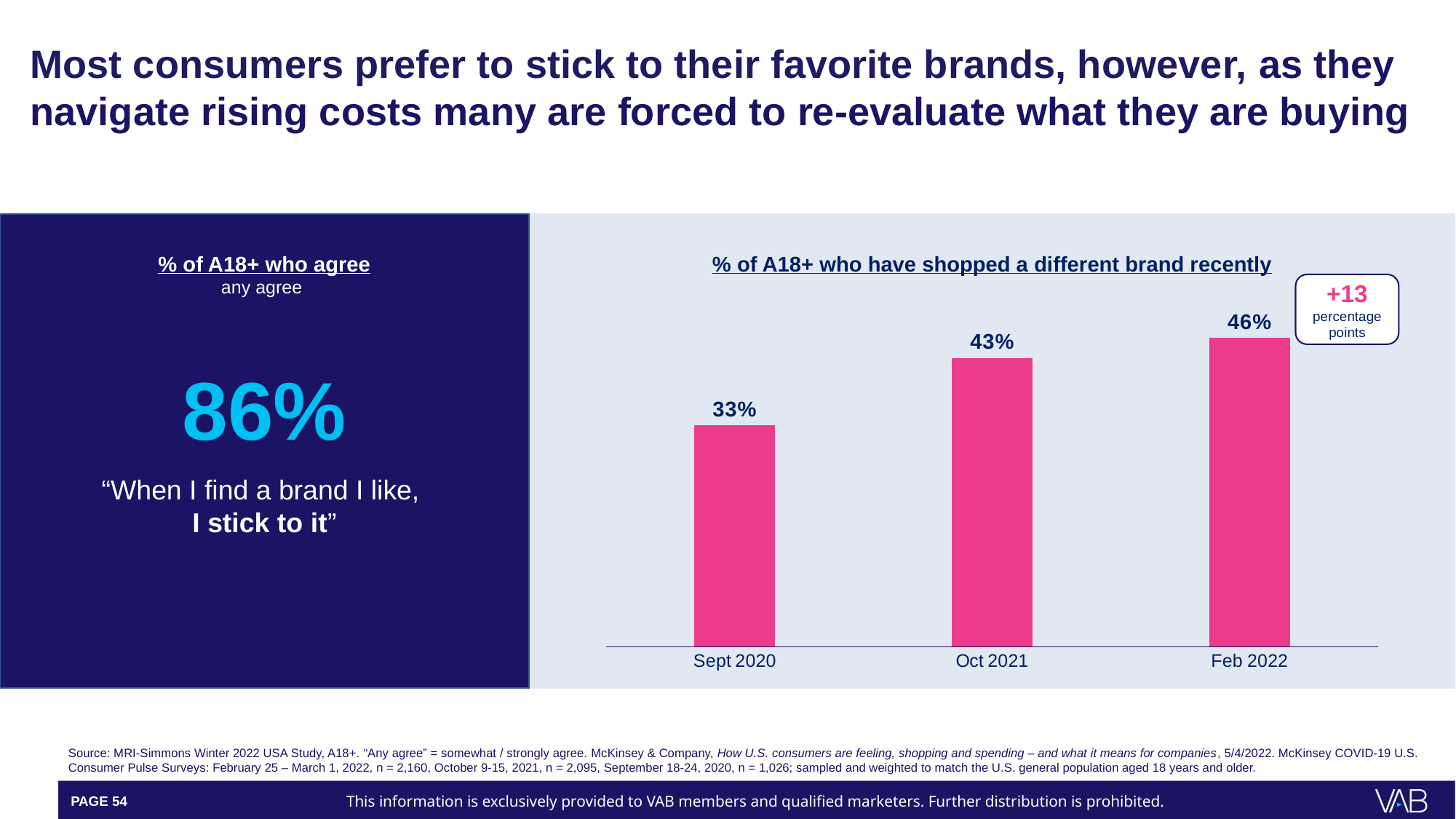
What is the difference between the Oct 2021 and Sept 2020 values in the chart of A18+ who have shopped a different brand recently? 10 percentage points What is the difference in percentage points between Feb 2022 and Sept 2020 in the chart of A18+ who have shopped a different brand recently? 13 percentage points What percentage of A18+ had shopped a different brand recently in Oct 2021? 43% What percentage of A18+ had shopped a different brand recently in Feb 2022? 46% Which period has the highest share of A18+ who have shopped a different brand recently? Feb 2022 What is the title of the chart on the right side of the slide? % of A18+ who have shopped a different brand recently Which is larger in the chart: the value for Oct 2021 or the value for Sept 2020? Oct 2021 What type of chart is used to show the % of A18+ who have shopped a different brand recently? Bar chart Do the values in the chart rise or fall from Sept 2020 to Feb 2022? Rise Which period has the lowest share of A18+ who have shopped a different brand recently? Sept 2020 How many time periods are shown in the chart of A18+ who have shopped a different brand recently? 3 What percentage of A18+ had shopped a different brand recently in Sept 2020? 33%